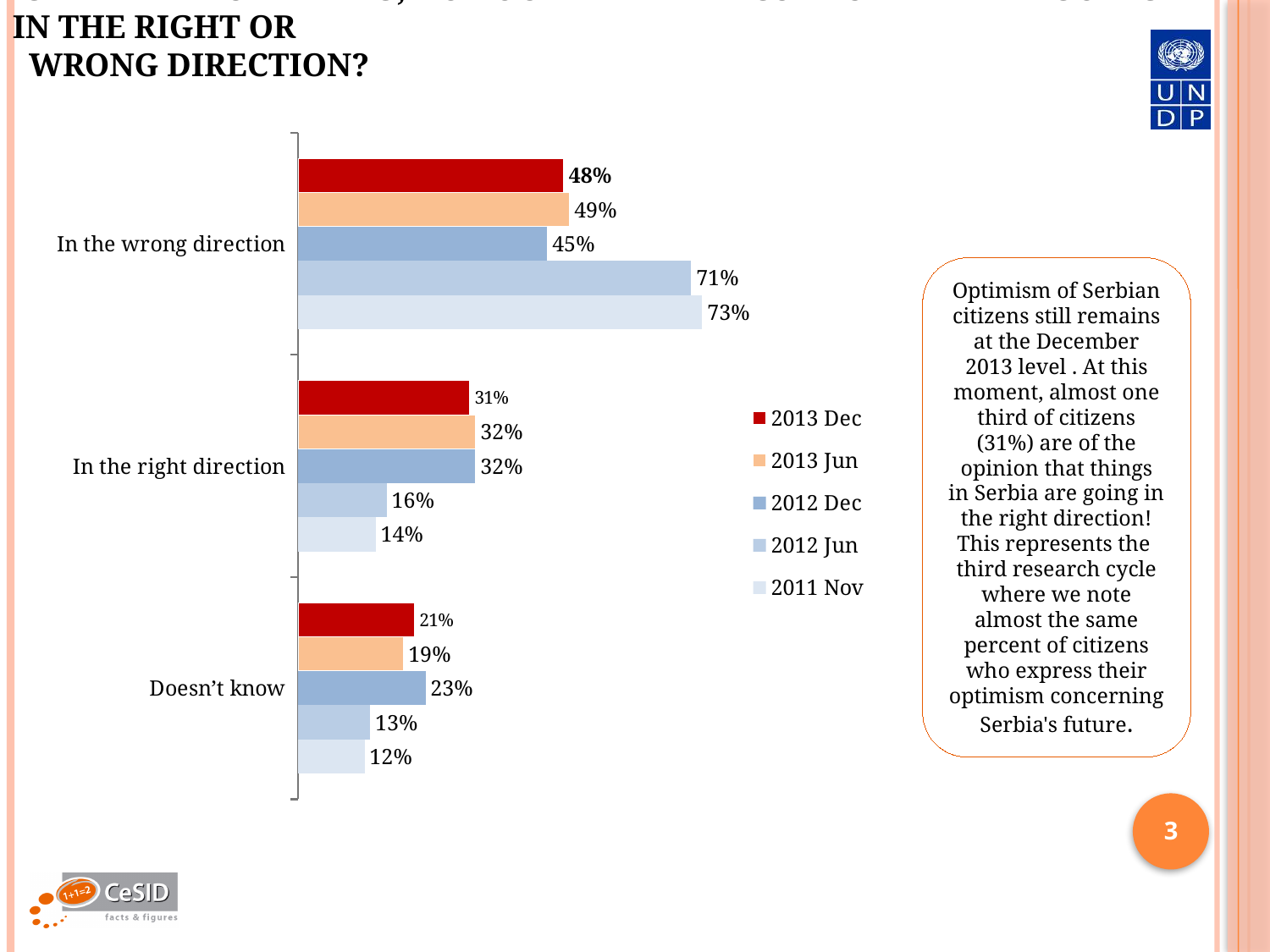
What is the value for 2012 Dec in the "Doesn't know" category? 23% What is the value for 2013 Dec in the "In the wrong direction" category? 48% How many series does the legend list? 5 Which is larger in the "In the right direction" category: 2013 Dec or 2012 Jun? 2013 Dec Which series has the highest value in the "In the wrong direction" category? 2011 Nov What kind of chart is shown on the slide? Bar chart Which series has the lowest value in the "Doesn't know" category? 2011 Nov How many categories are shown on the chart? 3 What is the difference between the 2012 Jun and 2013 Dec values in the "In the wrong direction" category? 23% Which legend entry is shown in dark red? 2013 Dec What is the value for 2011 Nov in the "In the right direction" category? 14% What is the difference between the 2013 Dec and 2013 Jun values in the "Doesn't know" category? 2%